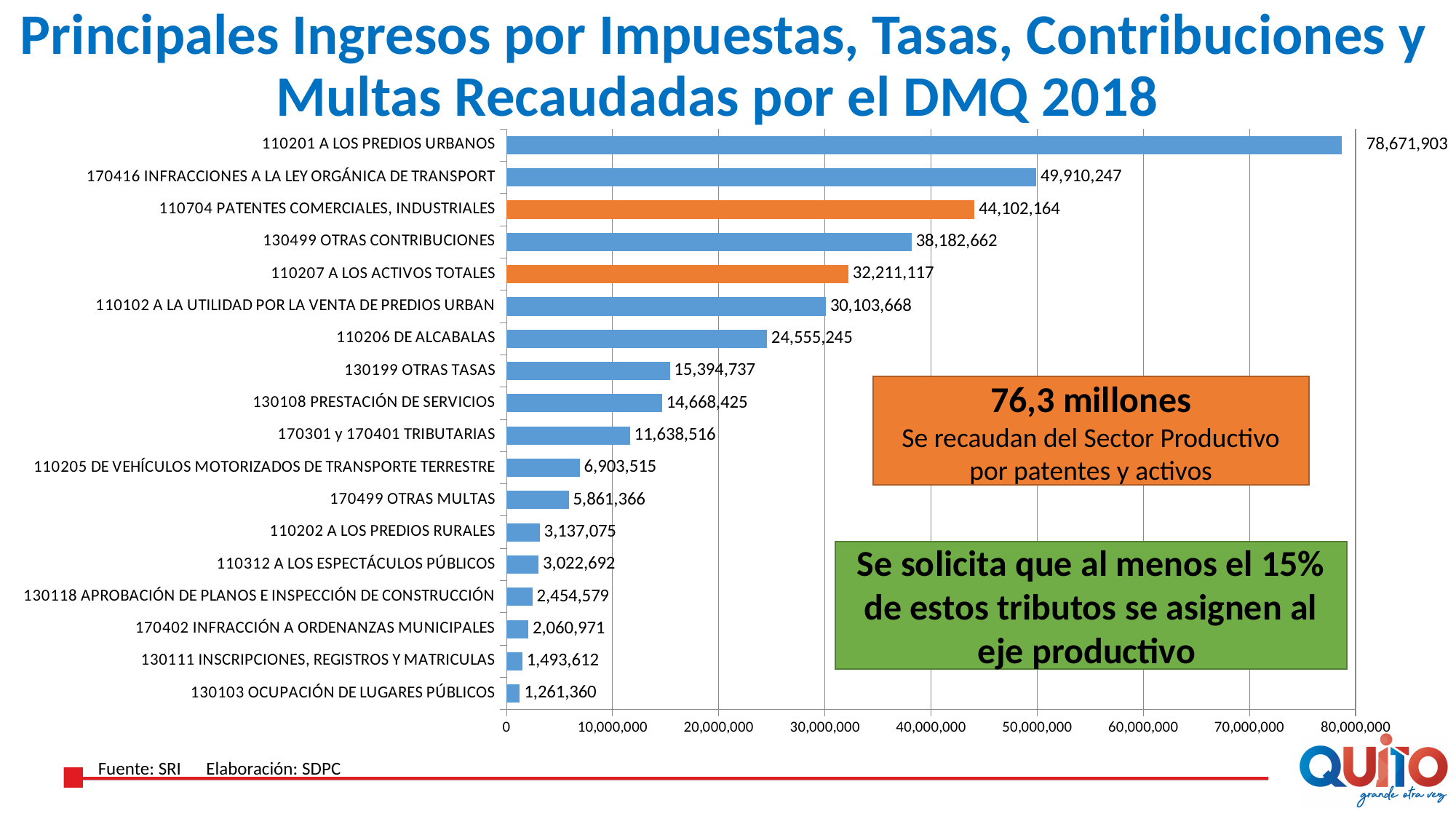
Which is larger, the value for 130199 OTRAS TASAS or the value for 130108 PRESTACIÓN DE SERVICIOS? 130199 OTRAS TASAS Is the value for 130499 OTRAS CONTRIBUCIONES greater or less than 40,000,000? less What type of chart is shown on the slide? Bar chart Which category has the highest value? 110201 A LOS PREDIOS URBANOS What is the value for 110206 DE ALCABALAS? 24,555,245 What is the value for 110704 PATENTES COMERCIALES, INDUSTRIALES? 44,102,164 How many categories are shown in the chart? 18 What is the combined value of the two orange bars (110704 PATENTES COMERCIALES, INDUSTRIALES and 110207 A LOS ACTIVOS TOTALES)? 76,313,281 What is the value for 110201 A LOS PREDIOS URBANOS? 78,671,903 What is the difference between the values for 110201 A LOS PREDIOS URBANOS and 170416 INFRACCIONES A LA LEY ORGÁNICA DE TRANSPORT? 28,761,656 Which category has the lowest value? 130103 OCUPACIÓN DE LUGARES PÚBLICOS What is the value for 130103 OCUPACIÓN DE LUGARES PÚBLICOS? 1,261,360